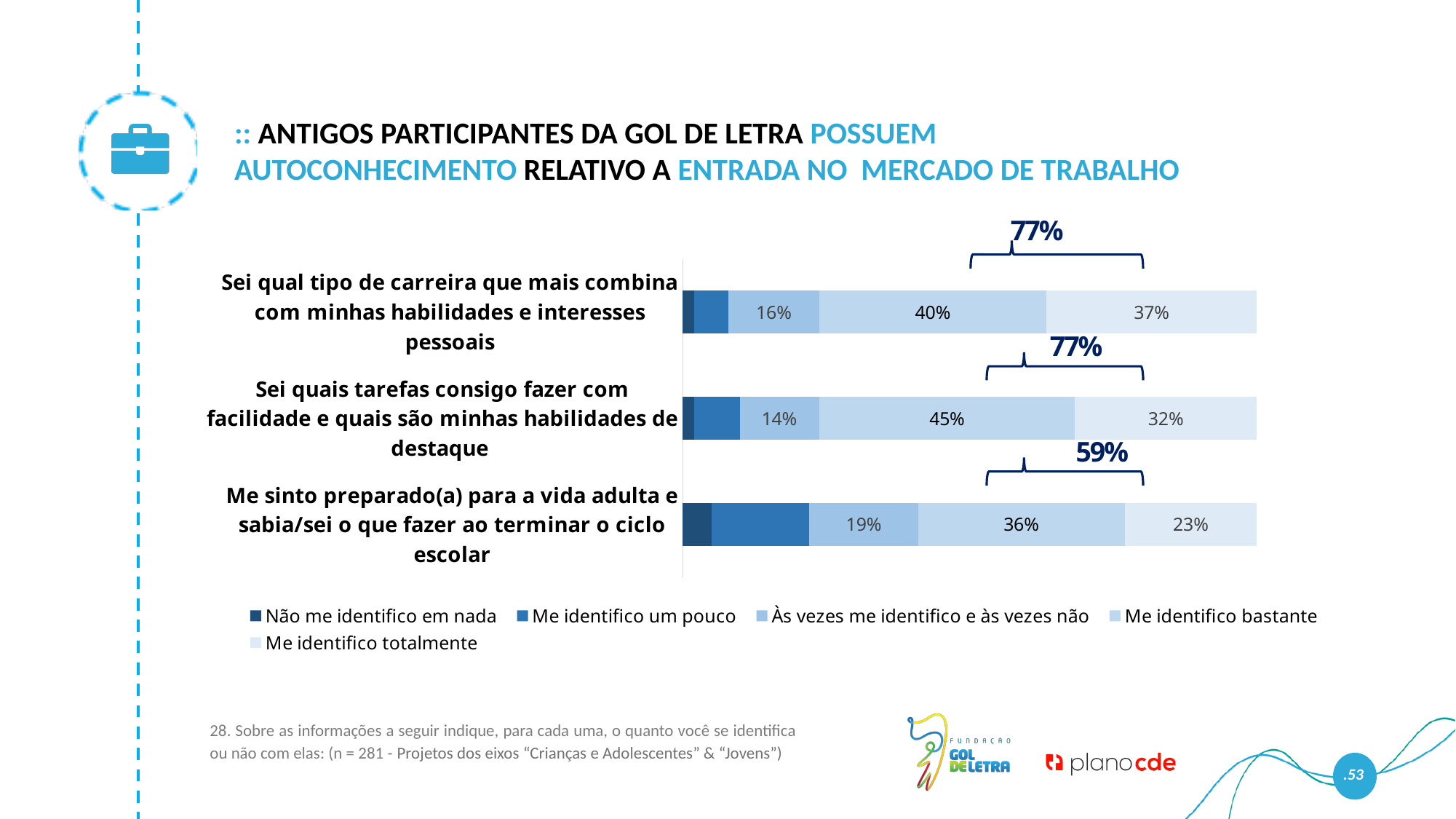
What is the value of 'Me identifico totalmente' for 'Sei qual tipo de carreira que mais combina com minhas habilidades e interesses pessoais'? 37% How many statements (categories) are plotted in the chart? 3 What is the value of 'Às vezes me identifico e às vezes não' for 'Me sinto preparado(a) para a vida adulta e sabia/sei o que fazer ao terminar o ciclo escolar'? 19% What combined percentage is shown by the bracket above the bar for 'Me sinto preparado(a) para a vida adulta e sabia/sei o que fazer ao terminar o ciclo escolar'? 59% What kind of chart is shown on the slide? Stacked bar chart What is the difference between the 'Me identifico totalmente' values for 'Sei qual tipo de carreira que mais combina com minhas habilidades e interesses pessoais' and 'Sei quais tarefas consigo fazer com facilidade e quais são minhas habilidades de destaque'? 5% What is the first series listed in the chart legend? Não me identifico em nada What is the value of 'Me identifico bastante' for 'Sei quais tarefas consigo fazer com facilidade e quais são minhas habilidades de destaque'? 45% Which statement has the highest 'Me identifico bastante' value? Sei quais tarefas consigo fazer com facilidade e quais são minhas habilidades de destaque Is the 'Às vezes me identifico e às vezes não' value larger for 'Sei qual tipo de carreira que mais combina com minhas habilidades e interesses pessoais' or for 'Sei quais tarefas consigo fazer com facilidade e quais são minhas habilidades de destaque'? Sei qual tipo de carreira que mais combina com minhas habilidades e interesses pessoais How many series does the legend list? 5 Which statement has the lowest 'Me identifico totalmente' value? Me sinto preparado(a) para a vida adulta e sabia/sei o que fazer ao terminar o ciclo escolar